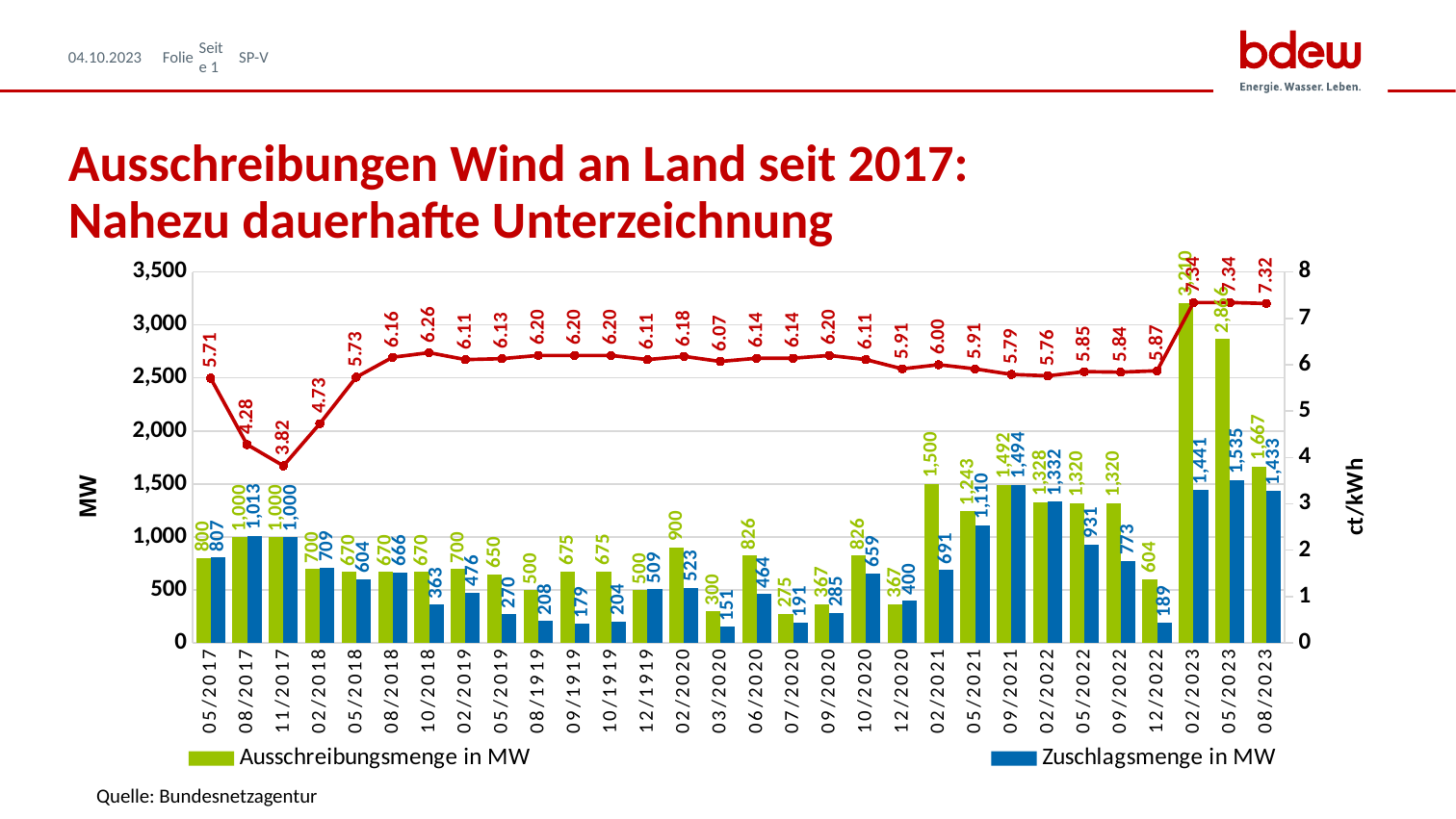
What is the Ausschreibungsmenge in MW for 02/2021? 1,500 In which period does the red line reach its lowest value? 11/2017 What unit is shown on the right-hand axis? ct/kWh Which period has the lowest Zuschlagsmenge in MW? 03/2020 How many series does the legend list? 2 For 10/2018, which is larger: the Ausschreibungsmenge or the Zuschlagsmenge? Ausschreibungsmenge How many periods are shown on the x axis? 30 Is the Zuschlagsmenge for 05/2022 greater or less than 1,000? less What is the Zuschlagsmenge in MW for 12/2022? 189 What is the difference between the Ausschreibungsmenge and the Zuschlagsmenge in 02/2021? 809 What value does the red line show for 11/2017? 3.82 Which period has the highest Ausschreibungsmenge in MW? 02/2023